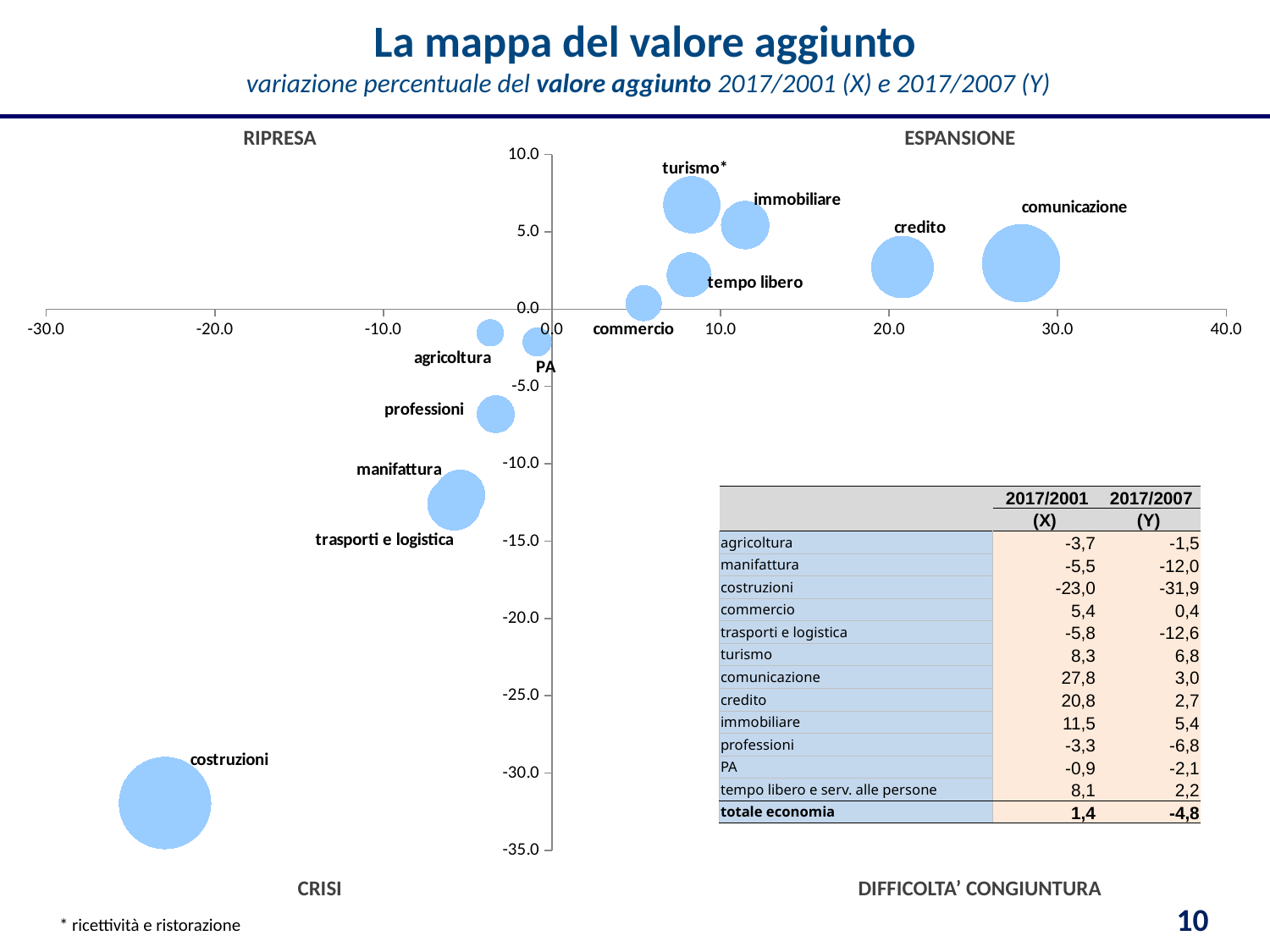
Which has the larger 2017/2007 (Y) value, turismo or immobiliare? turismo What is the 2017/2007 (Y) value for totale economia in the table? -4,8 How many sectors are plotted as bubbles on the chart? 12 What is the 2017/2007 (Y) percentage change for costruzioni? -31,9 Is the X value for costruzioni greater or less than -20.0? less Which sector has the highest 2017/2007 (Y) value? turismo What kind of chart is shown on the slide? bubble chart Which sector has the lowest 2017/2007 (Y) value? costruzioni What is the difference between the X values of comunicazione and credito? 7,0 Which sector has the highest 2017/2001 (X) value? comunicazione What label is given to the top-right quadrant of the chart? ESPANSIONE What is the 2017/2001 (X) percentage change for comunicazione? 27,8